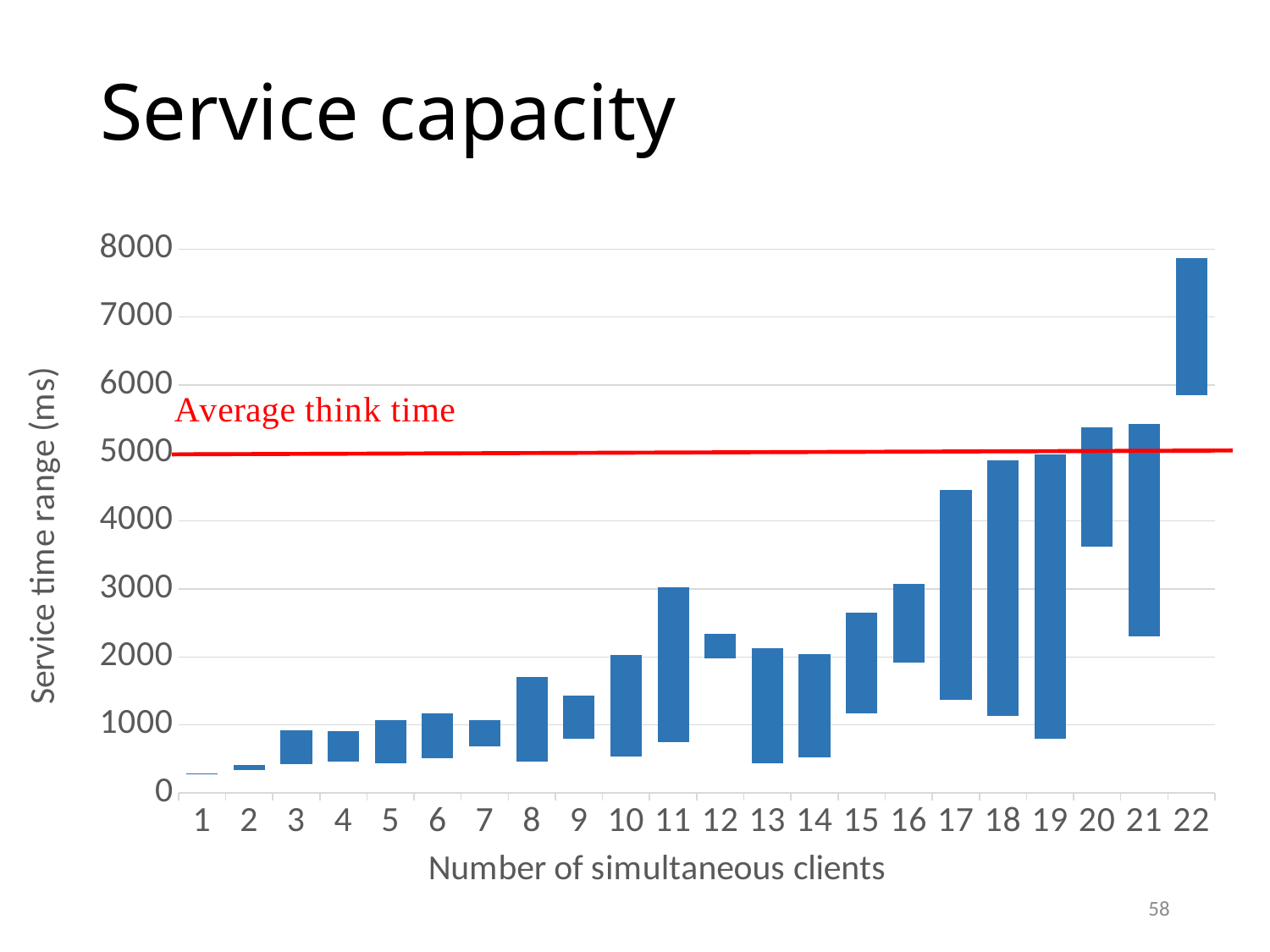
Which has a higher upper end of its service time range: 21 clients or 22 clients? 22 clients Do the service time ranges generally rise or fall as the number of simultaneous clients increases? Rise Which number of simultaneous clients has the lowest service time range? 1 Which has a higher upper end of its service time range: 15 clients or 16 clients? 16 clients What kind of chart is shown on the slide? Bar chart Which number of simultaneous clients has the highest upper end of its service time range? 22 Is the upper end of the service time range for 3 clients greater or less than 1000? less Is the upper end of the service time range for 17 clients greater or less than 5000? less What does the red horizontal line on the chart represent? Average think time Is the upper end of the service time range for 22 clients greater or less than 7000? greater How many values of number of simultaneous clients are plotted on the x axis? 22